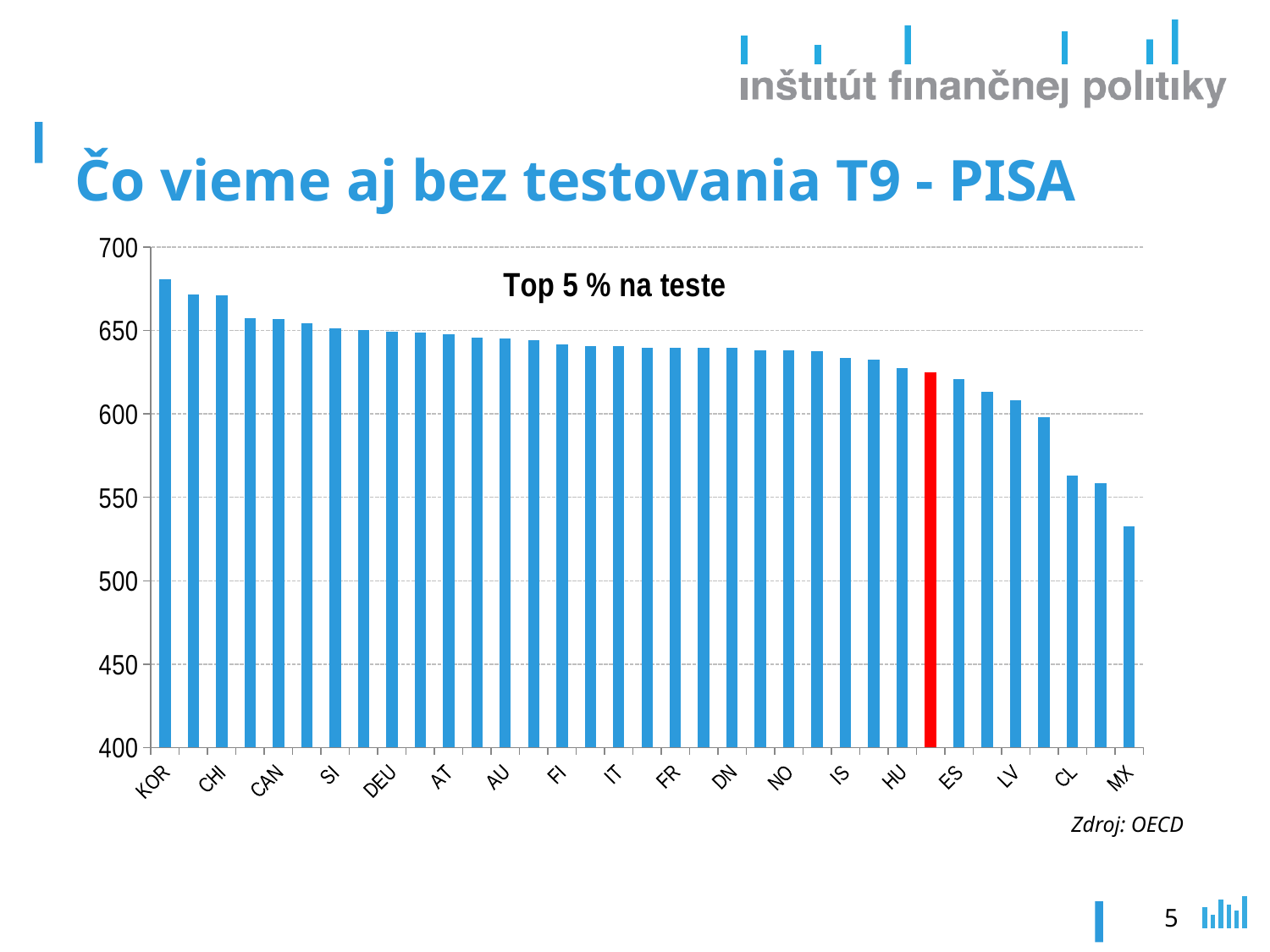
Do the values rise or fall moving from left to right along the x axis? fall What kind of chart is shown on the slide? bar chart What colour is the single highlighted bar that differs from the others? red Which has the larger value, MX or FI? FI Is the value for HU greater or less than 600? greater What is the title printed inside the chart? Top 5 % na teste Is the value for ES greater or less than 650? less Which country has the lowest value in the chart? MX Is the value for KOR greater or less than 650? greater Which has the larger value, CAN or CL? CAN Which country has the highest value in the chart? KOR